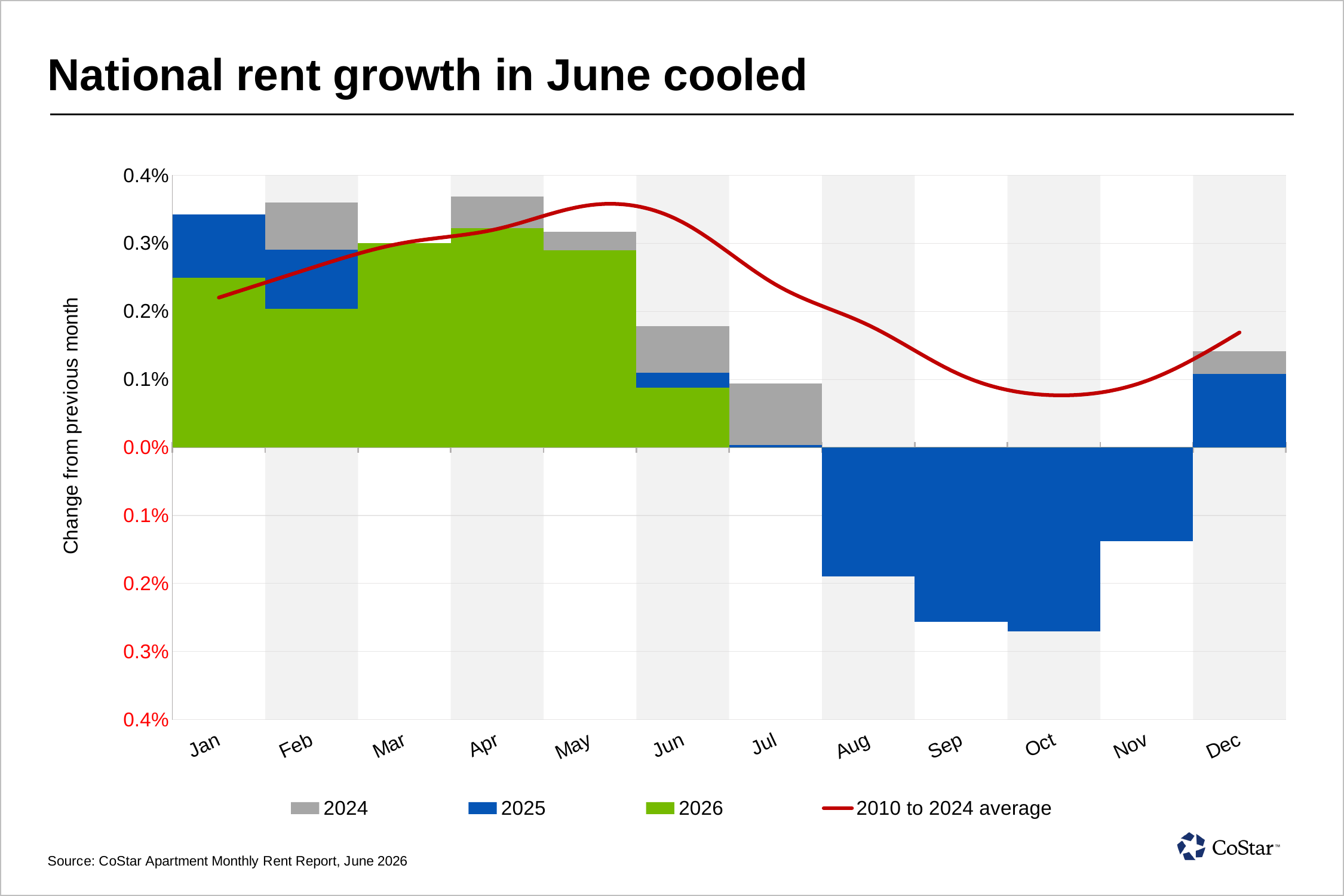
Is the 2026 value for Apr greater or less than 0.3%? greater Do the 2026 values rise or fall from Apr to Jun? fall What is the label of the line series in the legend? 2010 to 2024 average In Jun, which is larger: the 2025 value or the 2026 value? 2025 Is the 2025 value for Jan greater or less than 0.3%? greater How many series does the legend list? 4 In Feb, which is larger: the 2024 value or the 2025 value? 2024 Is the 2024 value for Jun greater or less than 0.2%? less What kind of chart is shown on the slide? Bar chart with a line series How many months are shown on the x axis? 12 Which month has the highest 2026 value? Apr